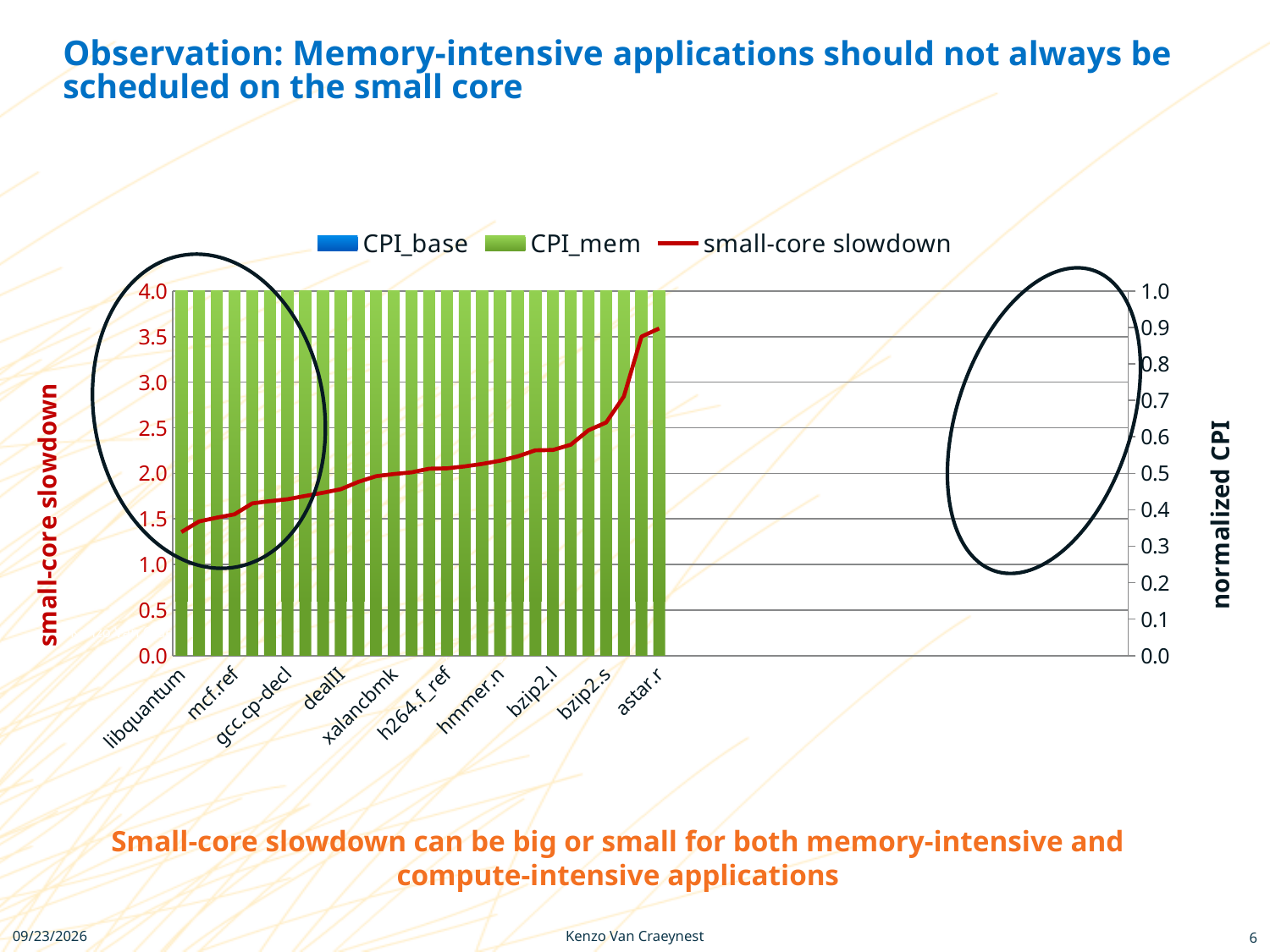
Which has the larger small-core slowdown, mcf.ref or bzip2.s? bzip2.s Does the small-core slowdown line rise or fall from libquantum to astar.r? Rises How many series does the chart legend list? 3 Is the small-core slowdown for bzip2.l greater or less than 2.0? greater What is the title of the right vertical axis? normalized CPI Which application has the highest small-core slowdown? astar.r Is the small-core slowdown for dealII greater or less than 2.0? less Is the small-core slowdown for astar.r greater or less than 3.0? greater What kind of chart is shown on the slide? Bar chart with a line series Which application has the lowest small-core slowdown? libquantum What is the title of the left vertical axis? small-core slowdown